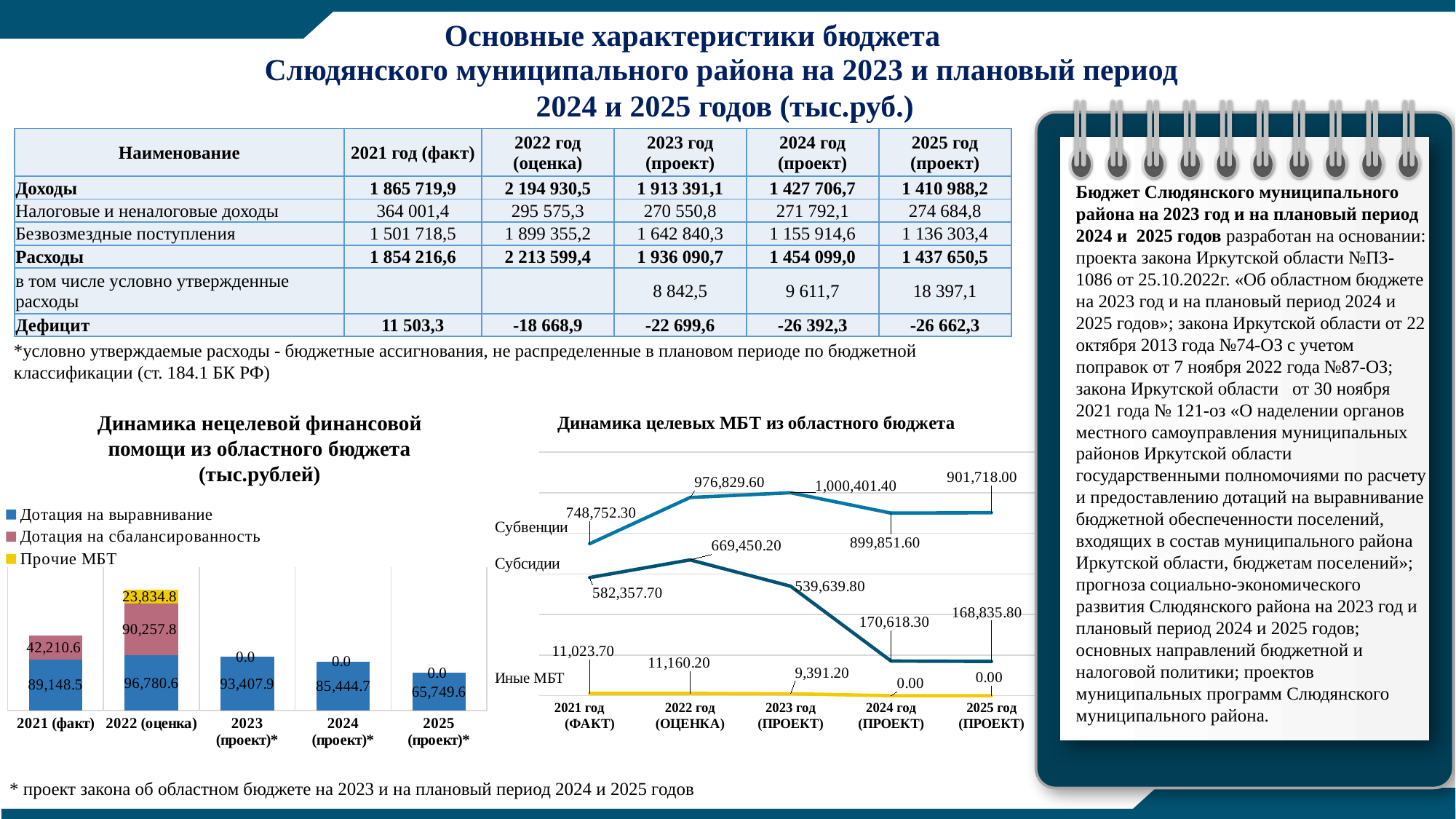
In the left chart 'Динамика нецелевой финансовой помощи из областного бюджета', what is the value of 'Дотация на выравнивание' for 2022 (оценка)? 96,780.6 In the right chart 'Динамика целевых МБТ из областного бюджета', how many years are shown on the x axis? 5 What kind of chart is the left chart 'Динамика нецелевой финансовой помощи из областного бюджета'? Stacked bar chart In the left chart 'Динамика нецелевой финансовой помощи из областного бюджета', which year has the lowest value of 'Дотация на выравнивание'? 2025 (проект)* In the left chart 'Динамика нецелевой финансовой помощи из областного бюджета', what is the value of 'Дотация на сбалансированность' for 2021 (факт)? 42,210.6 In the right chart 'Динамика целевых МБТ из областного бюджета', what is the value of 'Субсидии' for 2024 год (ПРОЕКТ)? 170,618.30 In the right chart 'Динамика целевых МБТ из областного бюджета', what is the value of 'Субвенции' for 2023 год (ПРОЕКТ)? 1,000,401.40 In the left chart 'Динамика нецелевой финансовой помощи из областного бюджета', how many series does the legend list? 3 In the left chart 'Динамика нецелевой финансовой помощи из областного бюджета', what is the value of 'Прочие МБТ' for 2022 (оценка)? 23,834.8 In the right chart 'Динамика целевых МБТ из областного бюджета', what is the difference between 'Субвенции' in 2023 год (ПРОЕКТ) and 2021 год (ФАКТ)? 251,649.10 In the right chart 'Динамика целевых МБТ из областного бюджета', which is larger: 'Субсидии' in 2022 год (ОЦЕНКА) or 'Субсидии' in 2023 год (ПРОЕКТ)? 2022 год (ОЦЕНКА) In the left chart 'Динамика нецелевой финансовой помощи из областного бюджета', what is the total of the stacked bar for 2022 (оценка)? 210,873.2